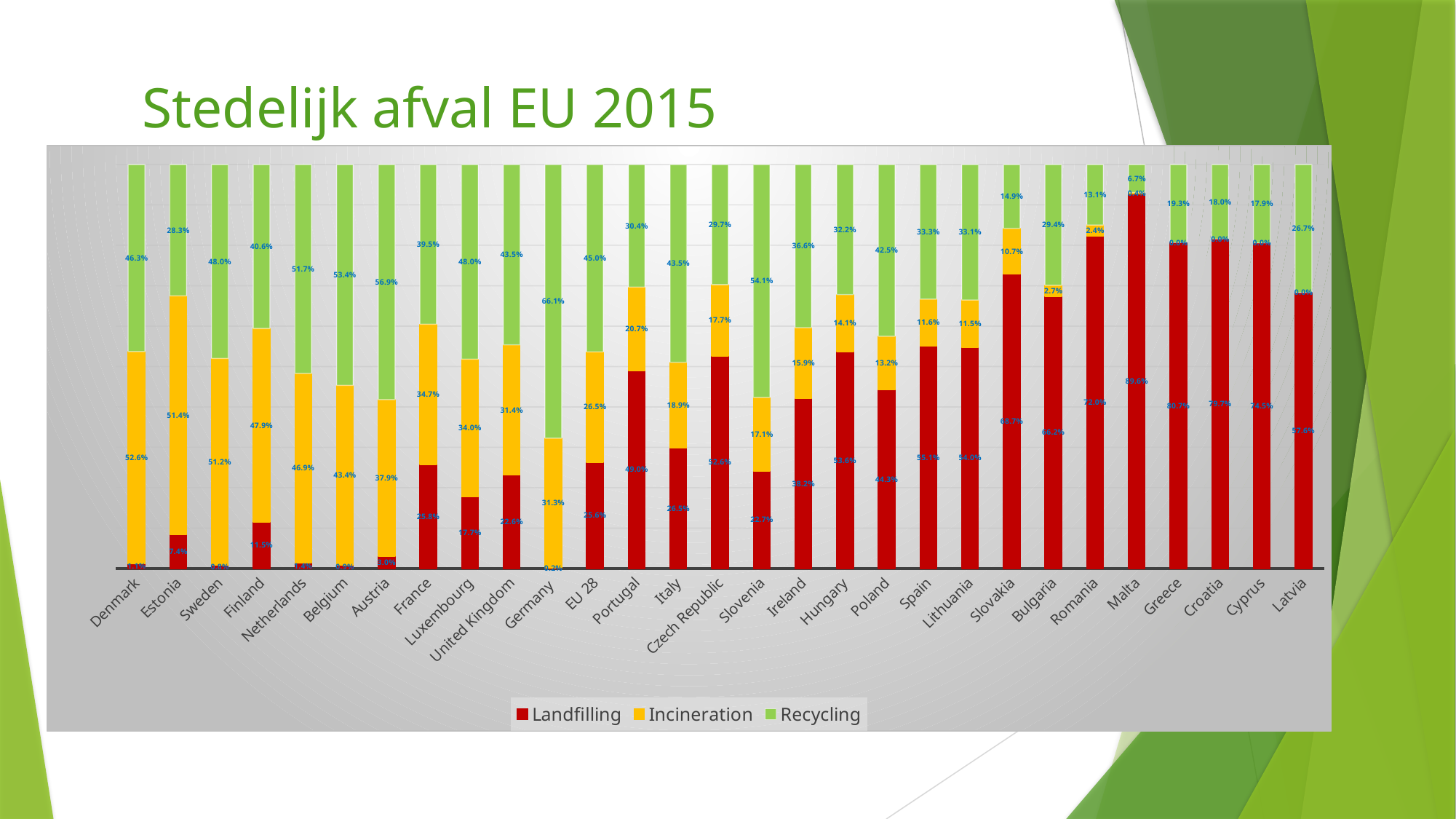
What is the Incineration share for Denmark? 52.6% Which country has the highest Landfilling share? Malta How many series does the legend list? 3 What is the difference in Recycling share between Germany and Denmark? 19.8 percentage points What kind of chart is shown on the slide? Stacked bar chart Which country has the highest Recycling share? Germany Which country has the lowest Recycling share? Malta What is the Recycling share for EU 28? 45.0% Which has a larger Landfilling share, Portugal or Italy? Portugal What is the Landfilling share for Malta? 89.6% What is the Recycling share for Germany? 66.1% How many countries/categories are shown along the x axis? 29